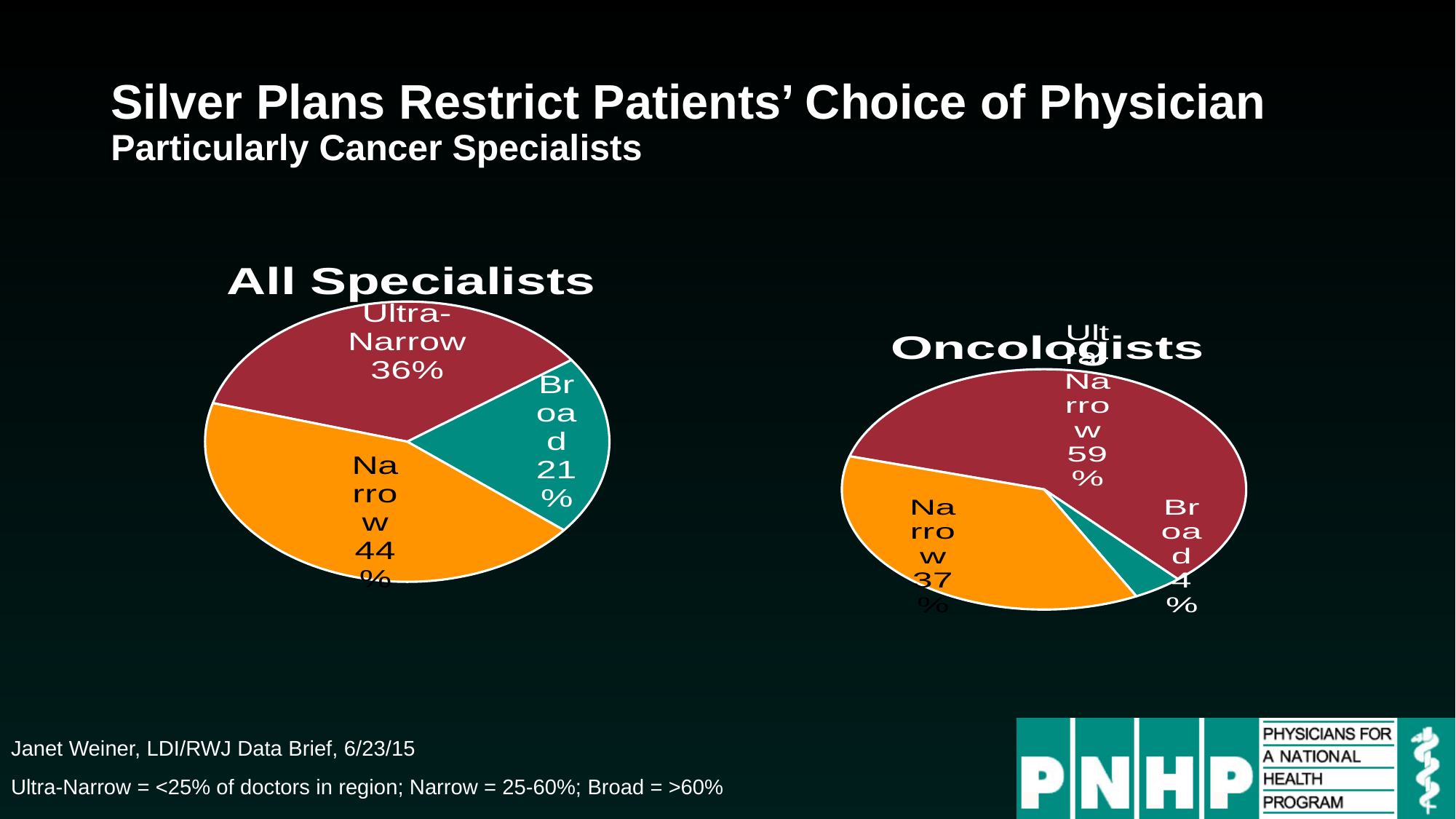
In the Oncologists chart, which category has the smallest slice? Broad In the All Specialists chart, what share of plans are Narrow? 44% In the Oncologists chart, which category has the largest slice? Ultra-Narrow What colour is the Narrow slice in both pie charts? Orange In the Oncologists chart, what share of plans are Ultra-Narrow? 59% In the All Specialists chart, which category has the largest slice? Narrow What type of chart is used for the Oncologists data? Pie chart Which is larger: the Broad share in the All Specialists chart or the Broad share in the Oncologists chart? All Specialists How many slices does the All Specialists pie chart have? 3 In the Oncologists chart, what share of plans are Broad? 4% In the All Specialists chart, what share of plans are Broad? 21% What is the difference between the Ultra-Narrow share in the Oncologists chart and the Ultra-Narrow share in the All Specialists chart? 23 percentage points